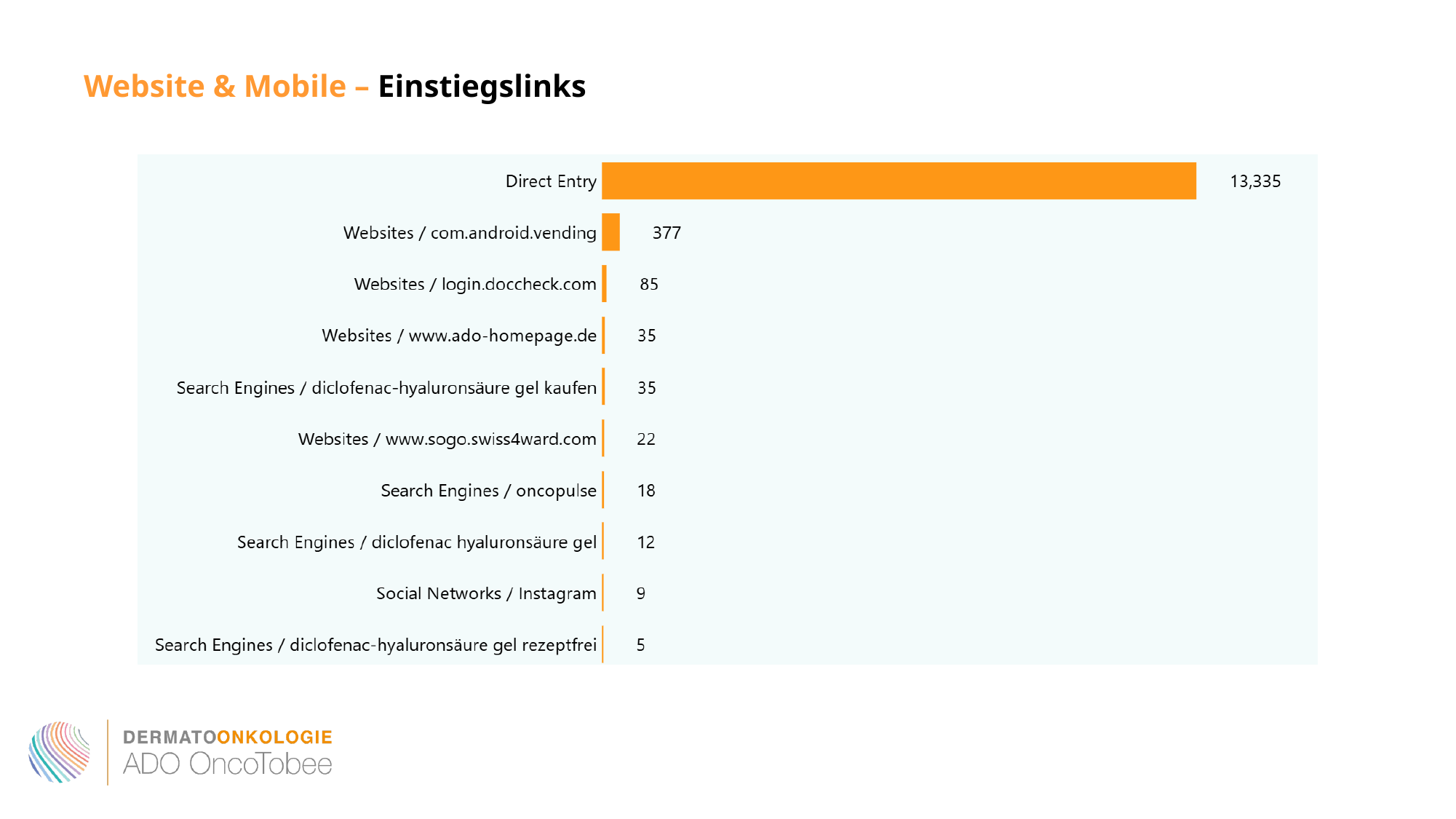
Which is larger, the value for Websites / www.sogo.swiss4ward.com or the value for Search Engines / oncopulse? Websites / www.sogo.swiss4ward.com What kind of chart is shown on the slide? Bar chart What is the value for Websites / login.doccheck.com? 85 What is the value for Websites / com.android.vending? 377 Which category has the highest value? Direct Entry What is the difference between the values for Search Engines / oncopulse and Search Engines / diclofenac hyaluronsäure gel? 6 What is the value for Social Networks / Instagram? 9 What is the difference between the values for Websites / com.android.vending and Websites / login.doccheck.com? 292 Which category has the lowest value? Search Engines / diclofenac-hyaluronsäure gel rezeptfrei What is the value for Direct Entry? 13,335 What is the title of the slide? Website & Mobile – Einstiegslinks How many categories are shown in the chart? 10